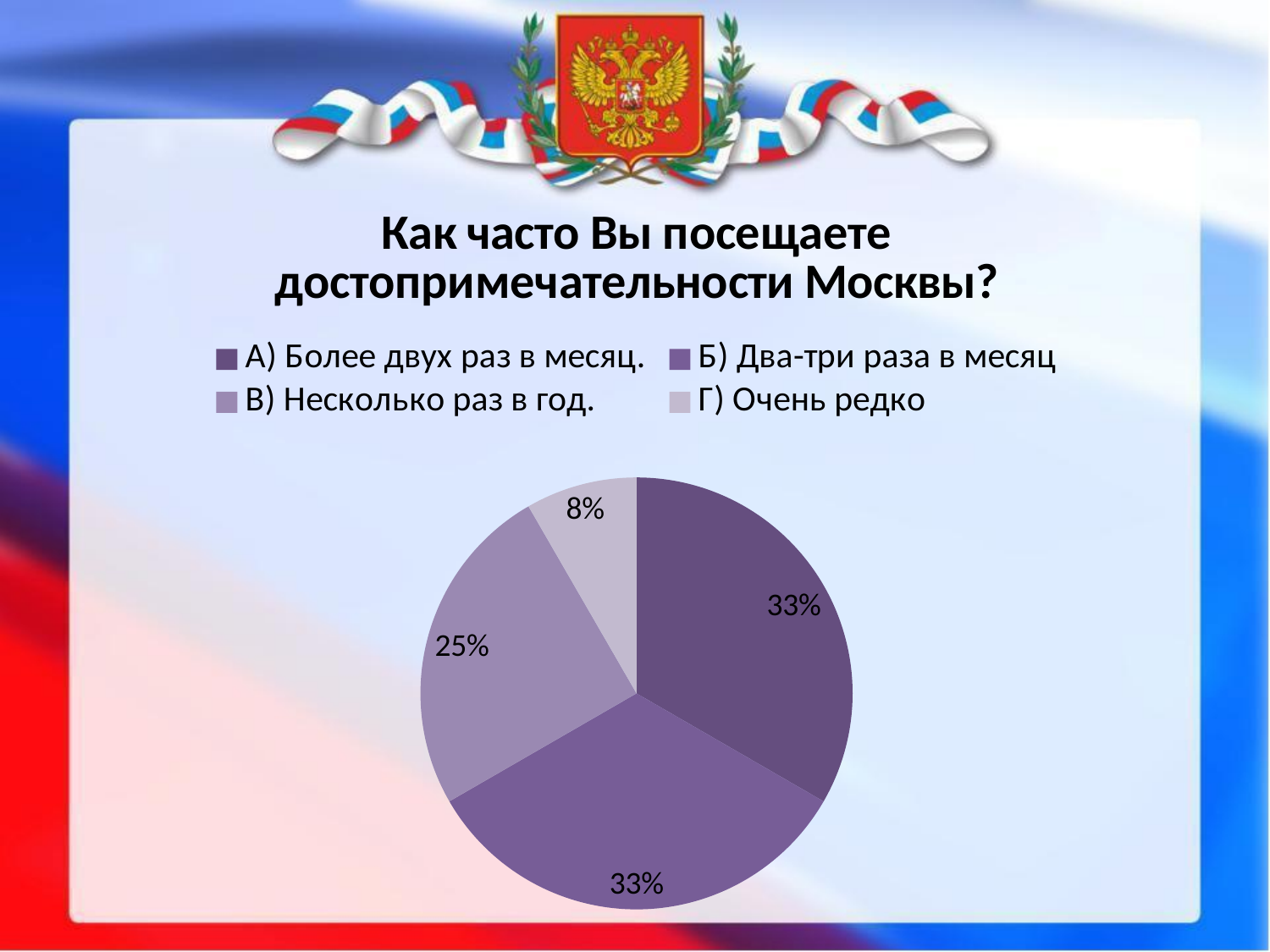
How many slices does the pie chart have? 4 Which is larger: the slice for "В) Несколько раз в год." or the slice for "Г) Очень редко"? В) Несколько раз в год. What is the title of the chart? Как часто Вы посещаете достопримечательности Москвы? What is the difference in percentage points between the slice for "А) Более двух раз в месяц." and the slice for "Г) Очень редко"? 25 How many entries does the legend list? 4 What share of the pie is labelled for "А) Более двух раз в месяц."? 33% What share of the pie is labelled for "Г) Очень редко"? 8% What kind of chart is shown on the slide? pie chart What share of the pie is labelled for "В) Несколько раз в год."? 25% Which category has the smallest slice of the pie? Г) Очень редко What is the difference in percentage points between the slice for "В) Несколько раз в год." and the slice for "Г) Очень редко"? 17